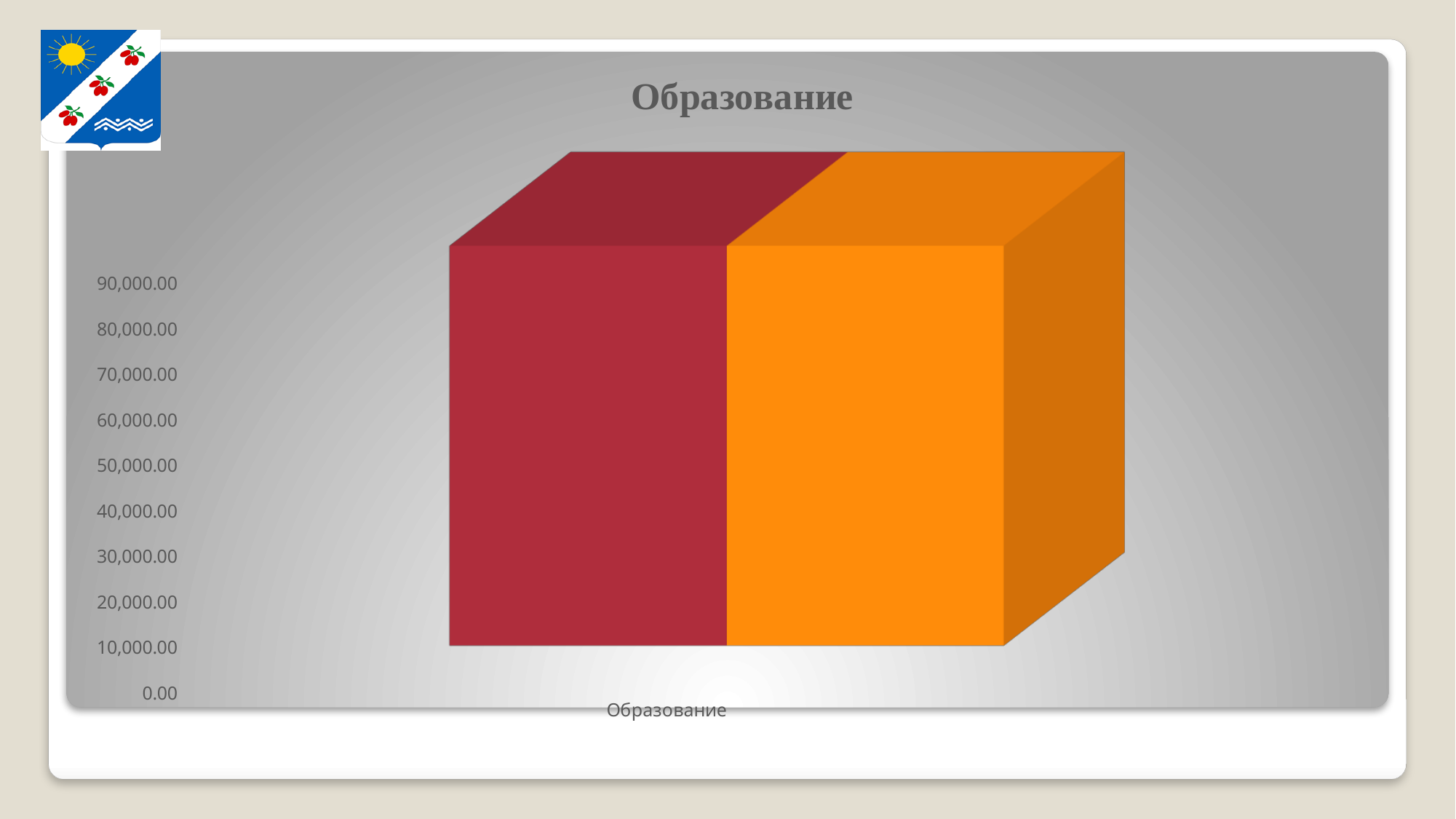
Is the value of the red bar greater or less than 30,000.00? greater What is the title of the chart? Образование Is the value of the orange bar greater or less than 50,000.00? greater Is the value of the red bar greater or less than 50,000.00? greater What colours are the two bars in the chart? red and orange How many categories are shown on the x axis of the chart? 1 What is the category label shown on the x axis? Образование How many bars are plotted in the chart? 2 What kind of chart is shown on the slide? bar chart